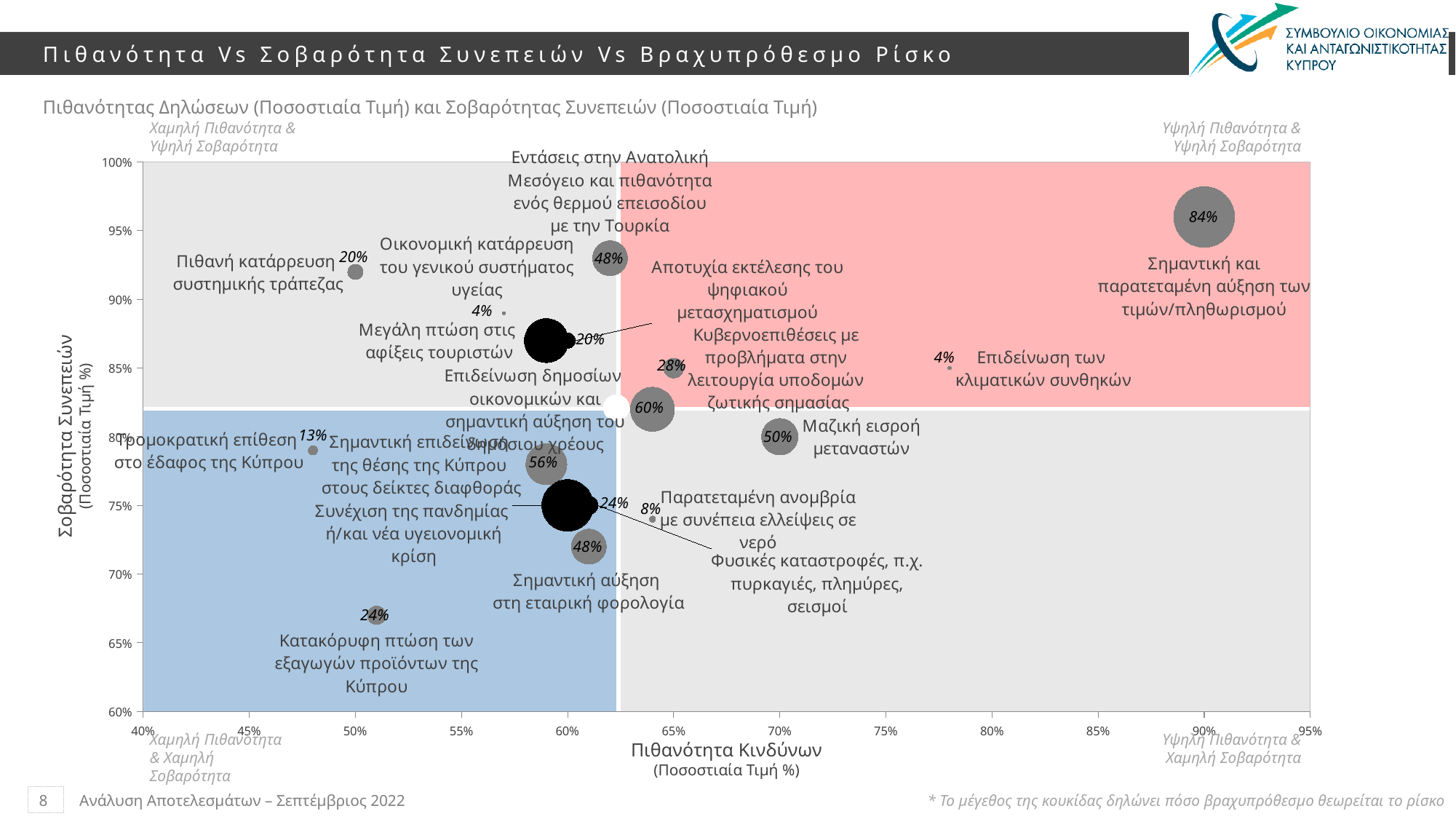
What is the bubble label for 'Επιδείνωση των κλιματικών συνθηκών'? 4% What is the bubble label (short-term risk value) for 'Σημαντική και παρατεταμένη αύξηση των τιμών/πληθωρισμού'? 84% What is the title of the x axis of the chart? Πιθανότητα Κινδύνων (Ποσοστιαία Τιμή %) Is the severity (y-axis) value for 'Κατακόρυφη πτώση των εξαγωγών προϊόντων της Κύπρου' greater or less than 70%? less Which risk has the largest bubble label value on the chart? Σημαντική και παρατεταμένη αύξηση των τιμών/πληθωρισμού Is the probability (x-axis) value for 'Σημαντική και παρατεταμένη αύξηση των τιμών/πληθωρισμού' greater or less than 85%? greater What kind of chart is shown on the slide? bubble chart What is the bubble label for 'Κατακόρυφη πτώση των εξαγωγών προϊόντων της Κύπρου'? 24% Which has the larger bubble label: 'Μαζική εισροή μεταναστών' or 'Κυβερνοεπιθέσεις με προβλήματα στην λειτουργία υποδομών ζωτικής σημασίας'? Μαζική εισροή μεταναστών What is the difference between the bubble labels for 'Σημαντική και παρατεταμένη αύξηση των τιμών/πληθωρισμού' (84%) and 'Μαζική εισροή μεταναστών' (50%)? 34 percentage points What is the bubble label for 'Τρομοκρατική επίθεση στο έδαφος της Κύπρου'? 13% What is the bubble label for 'Μαζική εισροή μεταναστών'? 50%